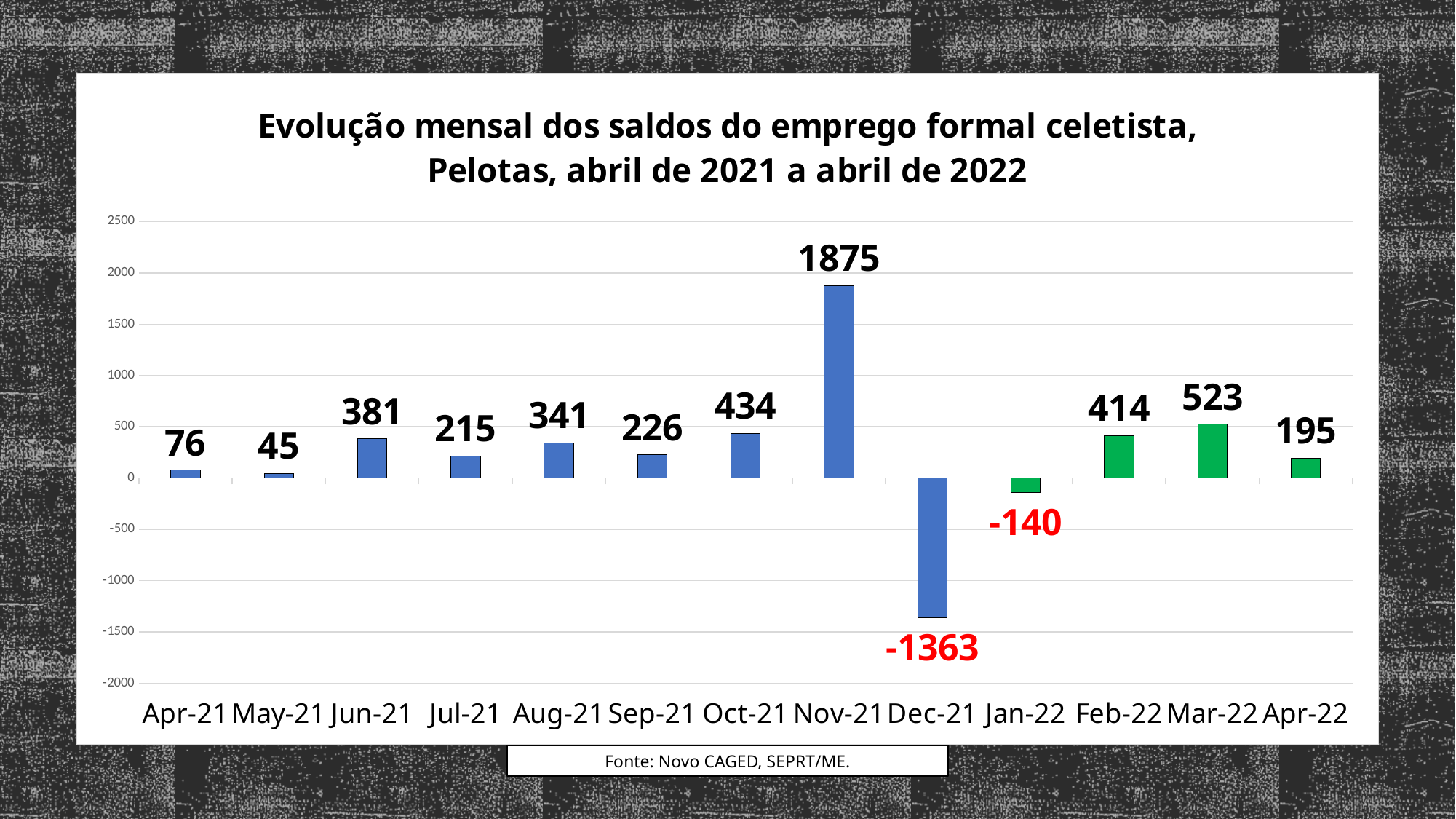
How many months are shown on the x axis? 13 What is the value for Jan-22? -140 What is the source cited below the chart? Novo CAGED, SEPRT/ME. What is the difference between the values for Mar-22 and Feb-22? 109 How many months have a negative value? 2 What kind of chart is this? Bar chart Which is larger, the value for Jun-21 or the value for Aug-21? Jun-21 Which month has the highest value? Nov-21 What is the value for Dec-21? -1363 What is the value for Nov-21? 1875 Which month has the lowest value? Dec-21 What is the value for Mar-22? 523